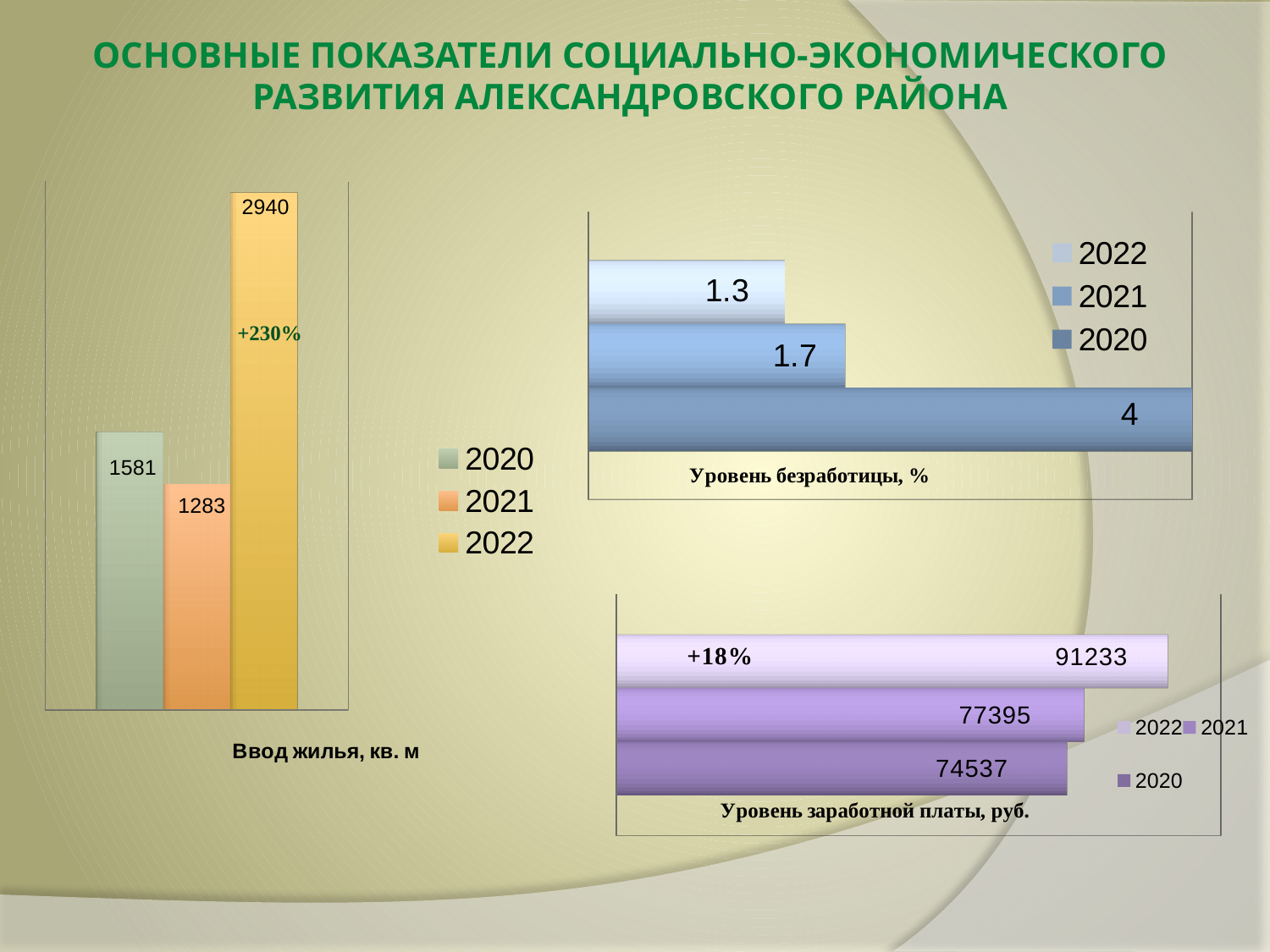
In the 'Уровень заработной платы, руб.' chart, what is the difference between the 2022 and 2021 values? 13838 In the 'Уровень безработицы, %' chart, which year has the highest value? 2020 In the 'Уровень заработной платы, руб.' chart, which is larger, the value for 2021 or for 2020? 2021 In the 'Ввод жилья, кв. м' chart, which year has the lowest value? 2021 How many series does the legend of the 'Ввод жилья, кв. м' chart list? 3 In the 'Ввод жилья, кв. м' chart, what is the value for 2021? 1283 In the 'Уровень заработной платы, руб.' chart, what is the value for 2022? 91233 In the 'Уровень безработицы, %' chart, what is the difference between the 2021 and 2022 values? 0.4 In the 'Ввод жилья, кв. м' chart, what is the difference between the 2022 and 2020 values? 1359 In the 'Уровень безработицы, %' chart, what is the value for 2022? 1.3 In the 'Уровень безработицы, %' chart, what is the value for 2020? 4 In the 'Ввод жилья, кв. м' chart, what is the value for 2022? 2940